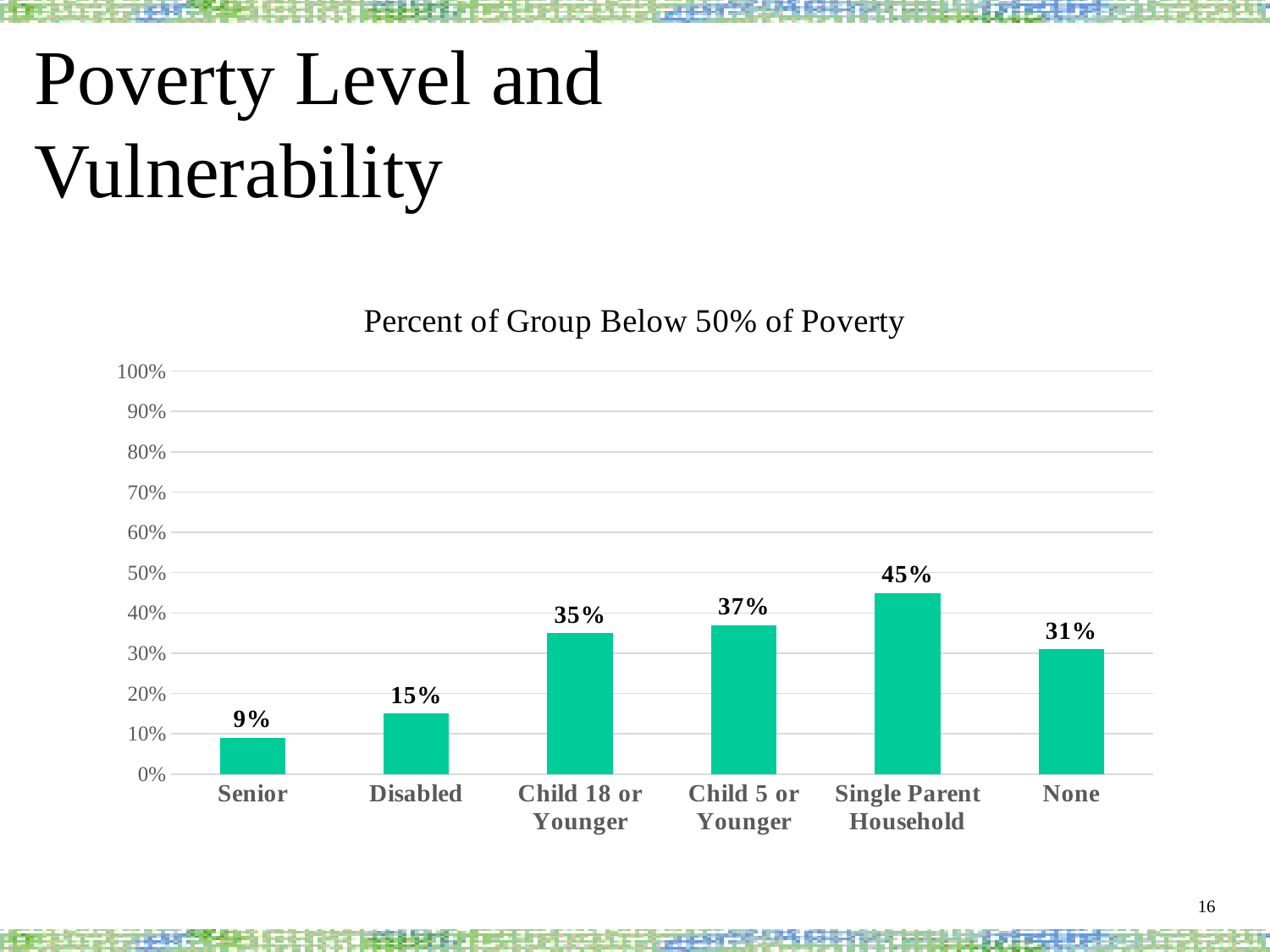
Which is larger, the value for Child 18 or Younger or the value for None? Child 18 or Younger What kind of chart is shown on the slide? bar chart What is the difference between the values for Disabled and Senior? 6% What is the difference between the values for Single Parent Household and None? 14% How many categories are shown on the x axis? 6 Is the value for Disabled greater or less than 20%? less Which category has the highest value? Single Parent Household Which category has the lowest value? Senior What is the value for Senior? 9% What is the value for Child 5 or Younger? 37% What is the title of the chart? Percent of Group Below 50% of Poverty What is the value for Single Parent Household? 45%